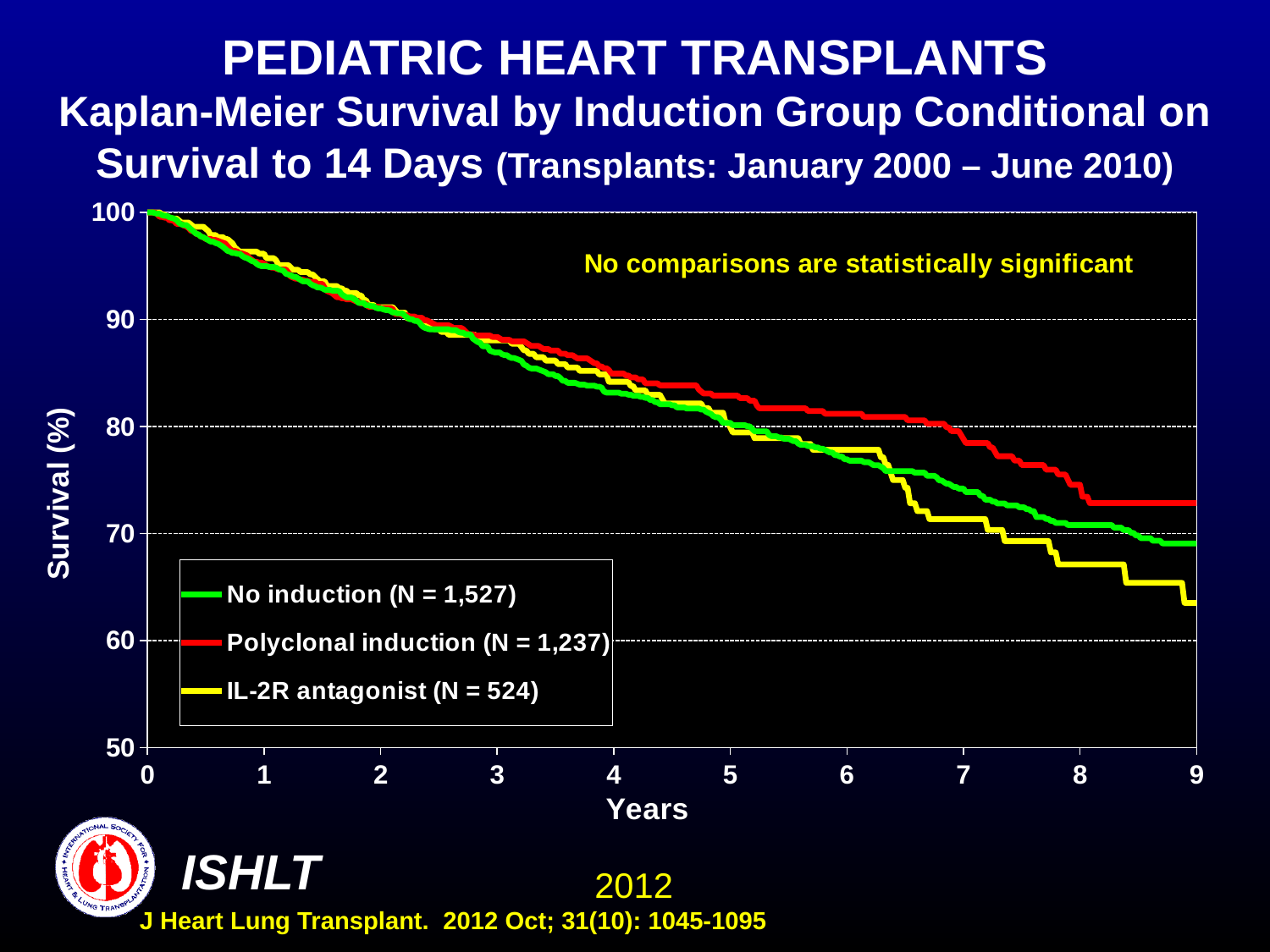
At 9 years, which has higher survival: the No induction group or the IL-2R antagonist group? No induction What kind of chart is shown on the slide? line chart What is the N for the IL-2R antagonist group shown in the legend? 524 According to the note on the chart, are any comparisons between the groups statistically significant? No Which induction group has the highest survival at 9 years? Polyclonal induction What is the N for the Polyclonal induction group shown in the legend? 1,237 Is the survival for the Polyclonal induction group at 9 years greater or less than 70? greater How many series does the legend list? 3 What is the N for the No induction group shown in the legend? 1,527 Is the survival for the IL-2R antagonist group at 9 years greater or less than 70? less Do the survival curves rise or fall as years increase? fall Which induction group has the lowest survival at 9 years? IL-2R antagonist